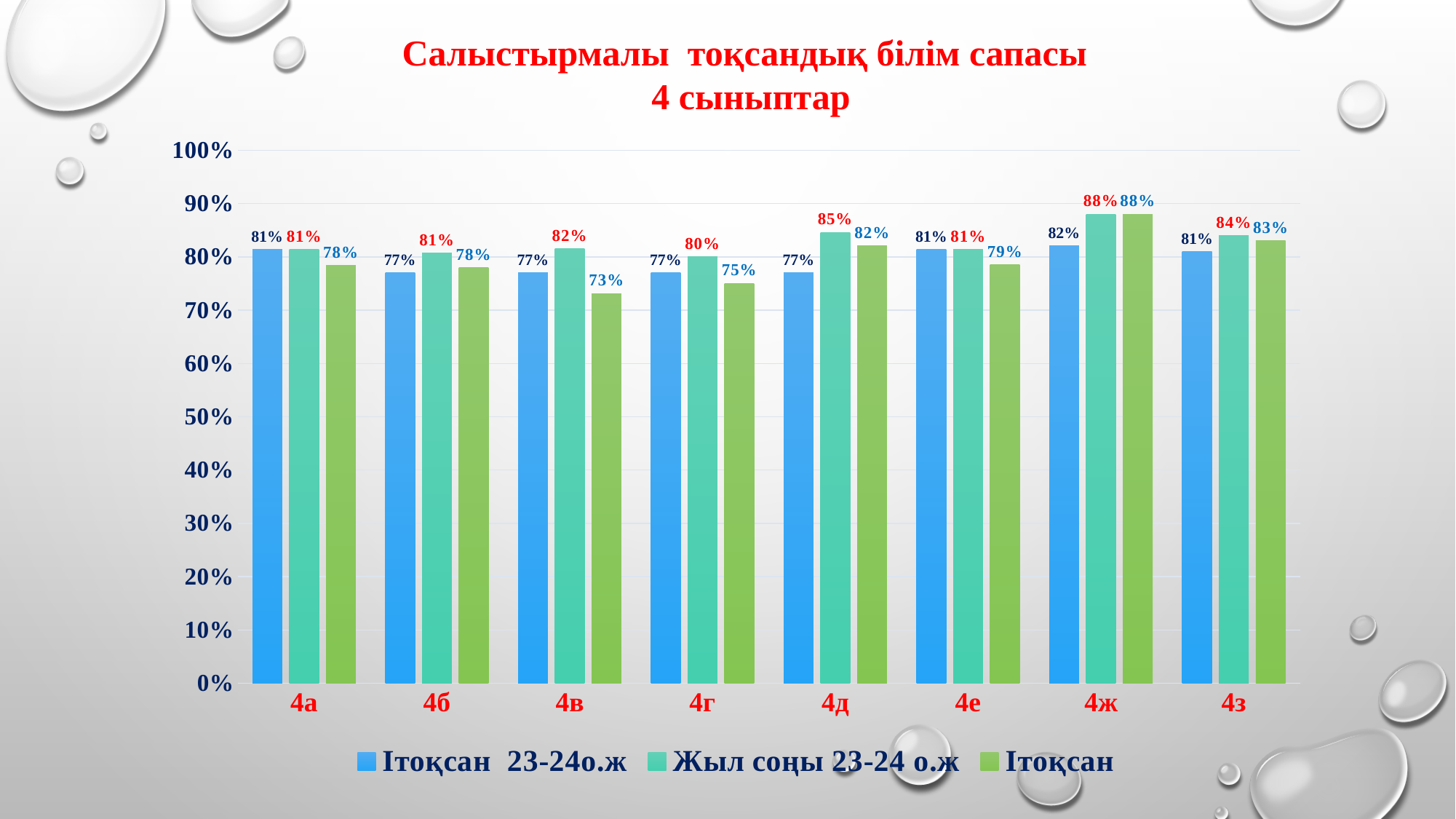
How many series does the legend list? 3 What is the value for 4д in the Жыл соңы 23-24 о.ж series? 85% What kind of chart is shown on the slide? bar chart Which is larger for 4г: the Жыл соңы 23-24 о.ж value or the Ітоқсан (green) value? Жыл соңы 23-24 о.ж Is the Ітоқсан (green) value for 4в greater or less than 80%? less Which class has the lowest value in the Ітоқсан series (the green bars)? 4в What is the difference between the Жыл соңы 23-24 о.ж value and the Ітоқсан 23-24о.ж value for 4д? 8% Which class has the highest value in the Жыл соңы 23-24 о.ж series? 4ж What is the value for 4в in the Ітоқсан series (the green bars)? 73% What is the value for 4ж in the Ітоқсан 23-24о.ж series? 82% What is the title of the chart? Салыстырмалы тоқсандық білім сапасы 4 сыныптар How many classes are shown on the x axis? 8